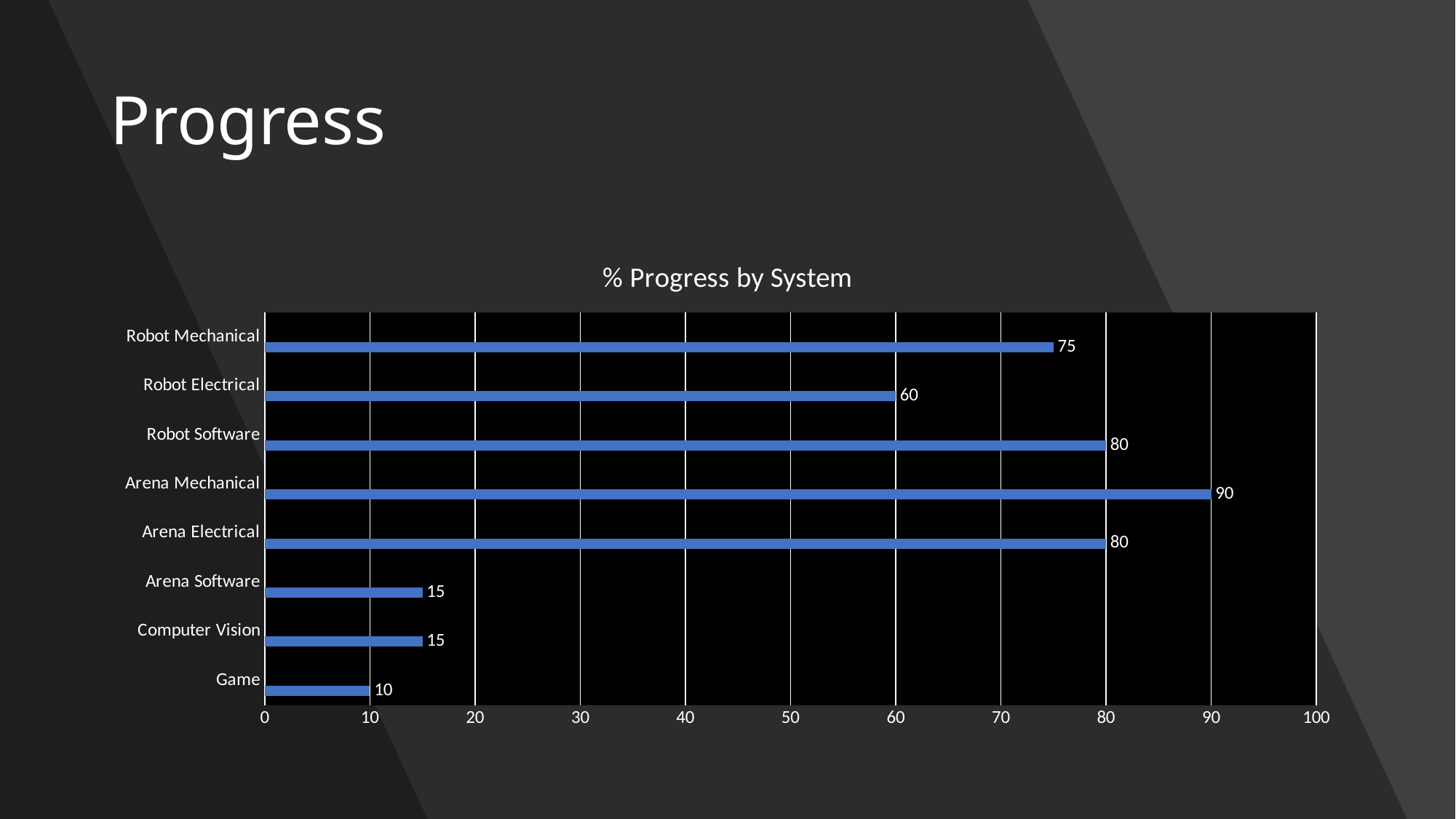
What is the value for Arena Software? 15 Which category has the highest value? Arena Mechanical What is the value for Robot Mechanical? 75 What is the value for Game? 10 What is the title of the chart? % Progress by System Is the value for Robot Electrical greater or less than 50? greater How many categories are shown in the chart? 8 Which is larger, the value for Robot Mechanical or the value for Robot Electrical? Robot Mechanical What is the difference between the values for Arena Mechanical and Robot Electrical? 30 What kind of chart is shown on the slide? bar chart What is the difference between the values for Robot Software and Game? 70 Which category has the lowest value? Game